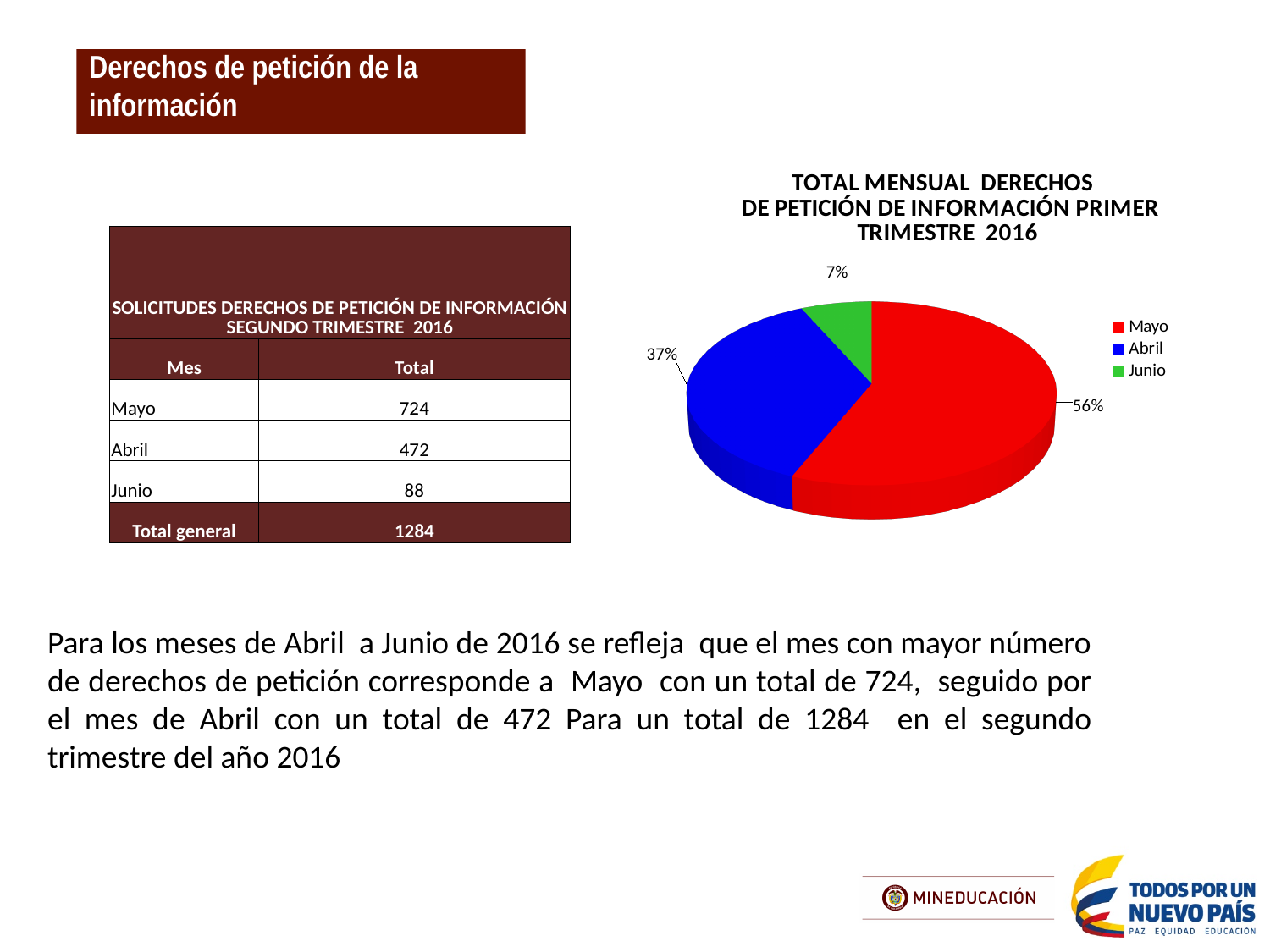
What is the difference in percentage points between the Mayo and Abril slices? 19% What colour is the Abril slice in the pie chart? blue Which month has the largest slice of the pie? Mayo What type of chart is shown on the slide? pie chart How many slices does the pie chart have? 3 What share of the pie does Abril represent? 37% What share of the pie does Mayo represent? 56% What is the title of the pie chart? TOTAL MENSUAL DERECHOS DE PETICIÓN DE INFORMACIÓN PRIMER TRIMESTRE 2016 Which slice is larger, Abril or Junio? Abril How many entries does the chart legend list? 3 Which month has the smallest slice of the pie? Junio What share of the pie does Junio represent? 7%